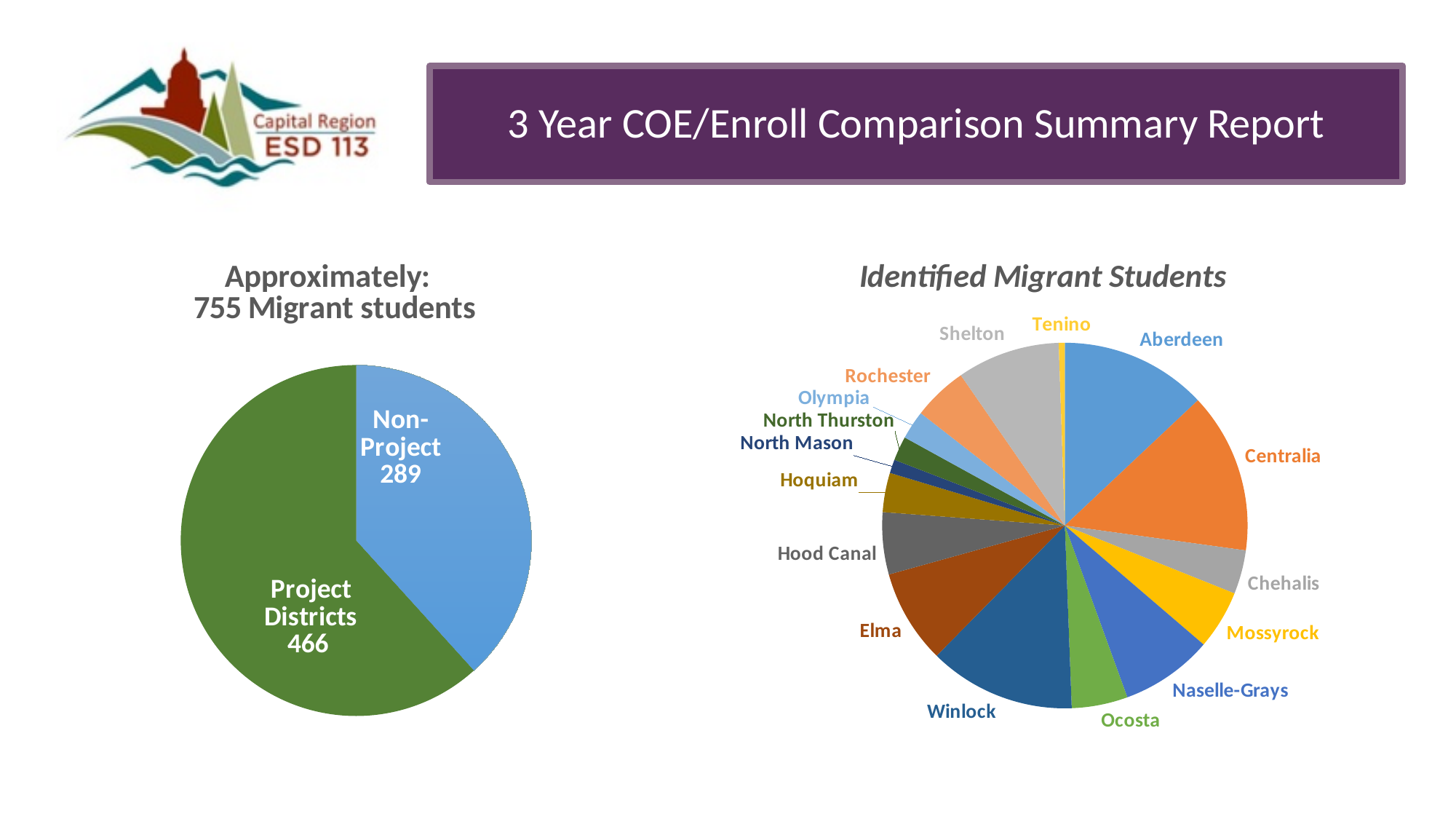
On the left pie chart, what is the difference between the Project Districts value and the Non-Project value? 177 On the left pie chart, what is the total of the two slices? 755 On the 'Identified Migrant Students' pie chart, which district has the largest slice? Centralia What kind of chart is the 'Identified Migrant Students' chart? Pie chart What is the title of the pie chart on the right side of the slide? Identified Migrant Students On the 'Identified Migrant Students' pie chart, which district has the smallest slice? Tenino On the 'Identified Migrant Students' pie chart, how many districts are shown? 16 On the 'Identified Migrant Students' pie chart, which slice is larger, Winlock or Ocosta? Winlock On the left pie chart, how many migrant students are in Project Districts? 466 On the left pie chart, how many slices are there? 2 On the left pie chart, what is the value for Non-Project? 289 On the left pie chart, which category has the larger value, Project Districts or Non-Project? Project Districts